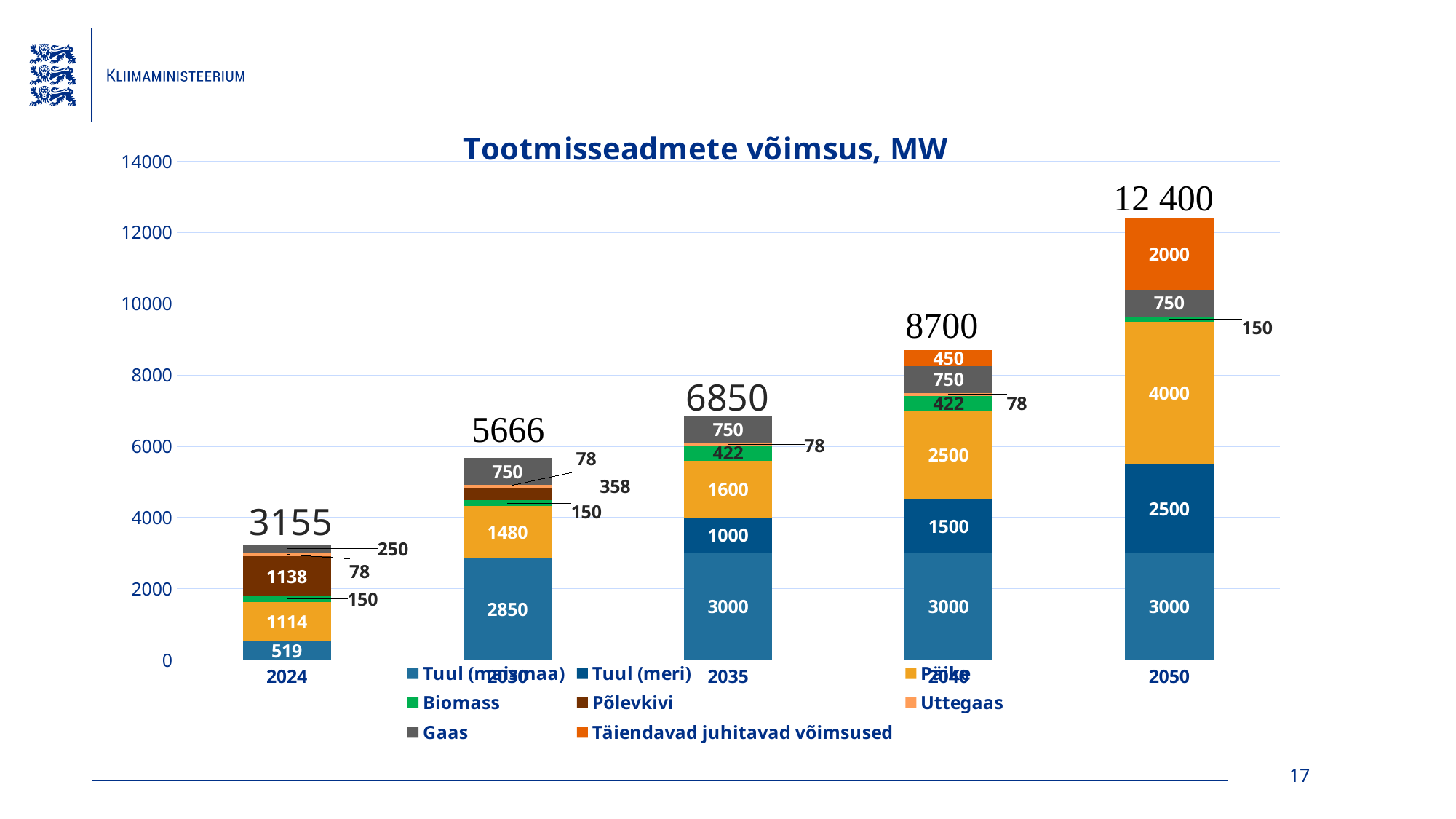
What is the difference between the total capacity in 2035 and in 2030? 1184 How many years (categories) are shown on the x axis? 5 What is the value for Päike (solar) in 2040? 2500 What is the total capacity shown above the 2050 bar? 12 400 Which year has the highest total capacity? 2050 Which year has the lowest total capacity? 2024 Which is larger: the Tuul (meri) value in 2050 or the Tuul (meri) value in 2040? Tuul (meri) in 2050 How many series does the legend list? 8 What is the value for Tuul (maismaa) in 2024? 519 Do the total capacities rise or fall from 2024 to 2050? Rise What is the value for Põlevkivi in 2030? 358 What kind of chart is shown on the slide? Stacked bar chart